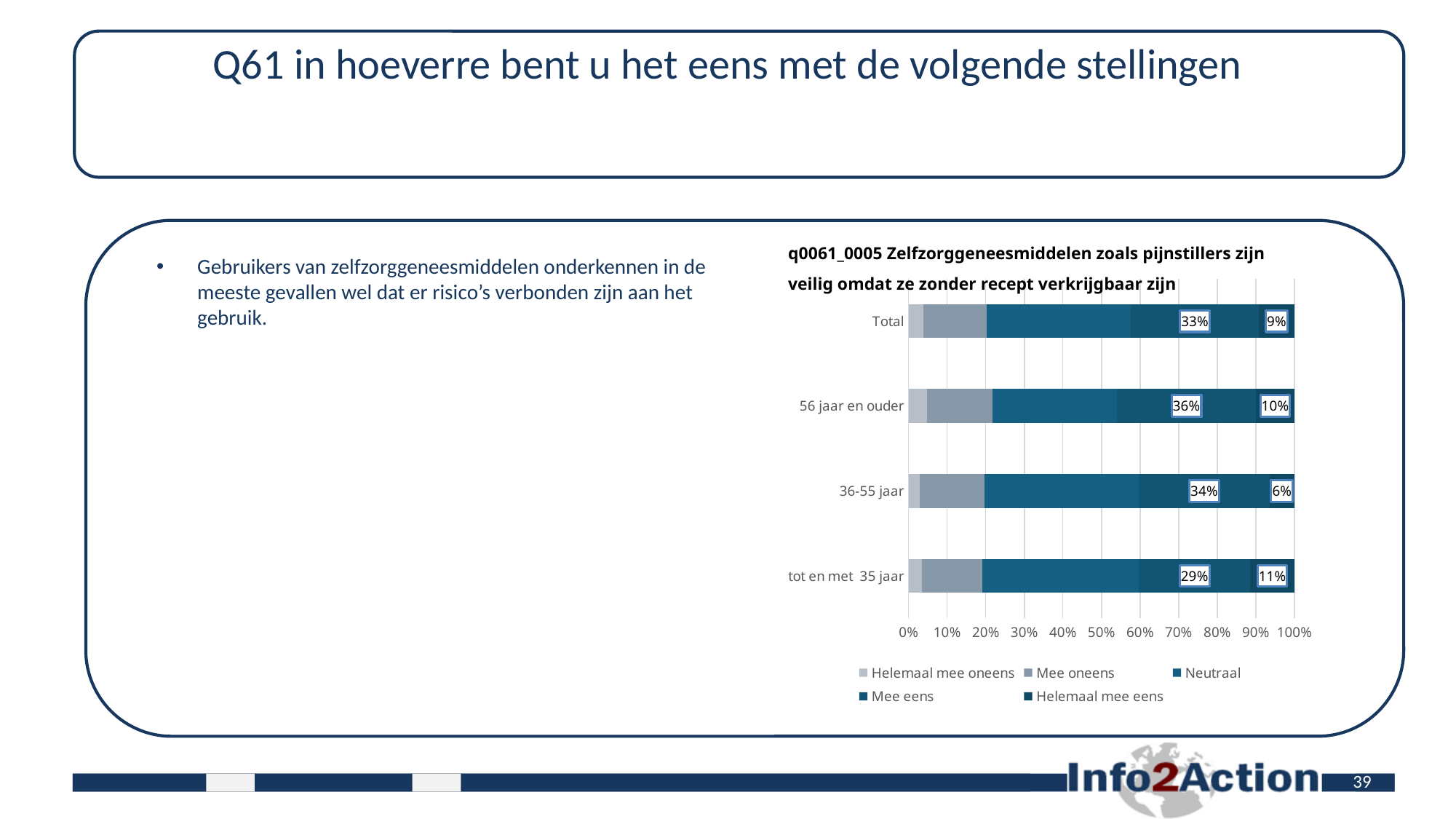
What is the value for "Helemaal mee eens" for 36-55 jaar? 6% What is the first legend entry of the chart? Helemaal mee oneens Which age group has the highest value for "Mee eens"? 56 jaar en ouder What is the value for "Helemaal mee eens" for 56 jaar en ouder? 10% What is the difference between the "Mee eens" values for 56 jaar en ouder and tot en met 35 jaar? 7% What is the value for "Mee eens" for tot en met 35 jaar? 29% What kind of chart is shown on the slide? Stacked bar chart What is the value for "Mee eens" for Total? 33% Which is larger: the "Helemaal mee eens" value for tot en met 35 jaar or for Total? tot en met 35 jaar How many series does the legend list? 5 Which category has the lowest value for "Helemaal mee eens"? 36-55 jaar How many categories are shown on the vertical axis of the chart? 4